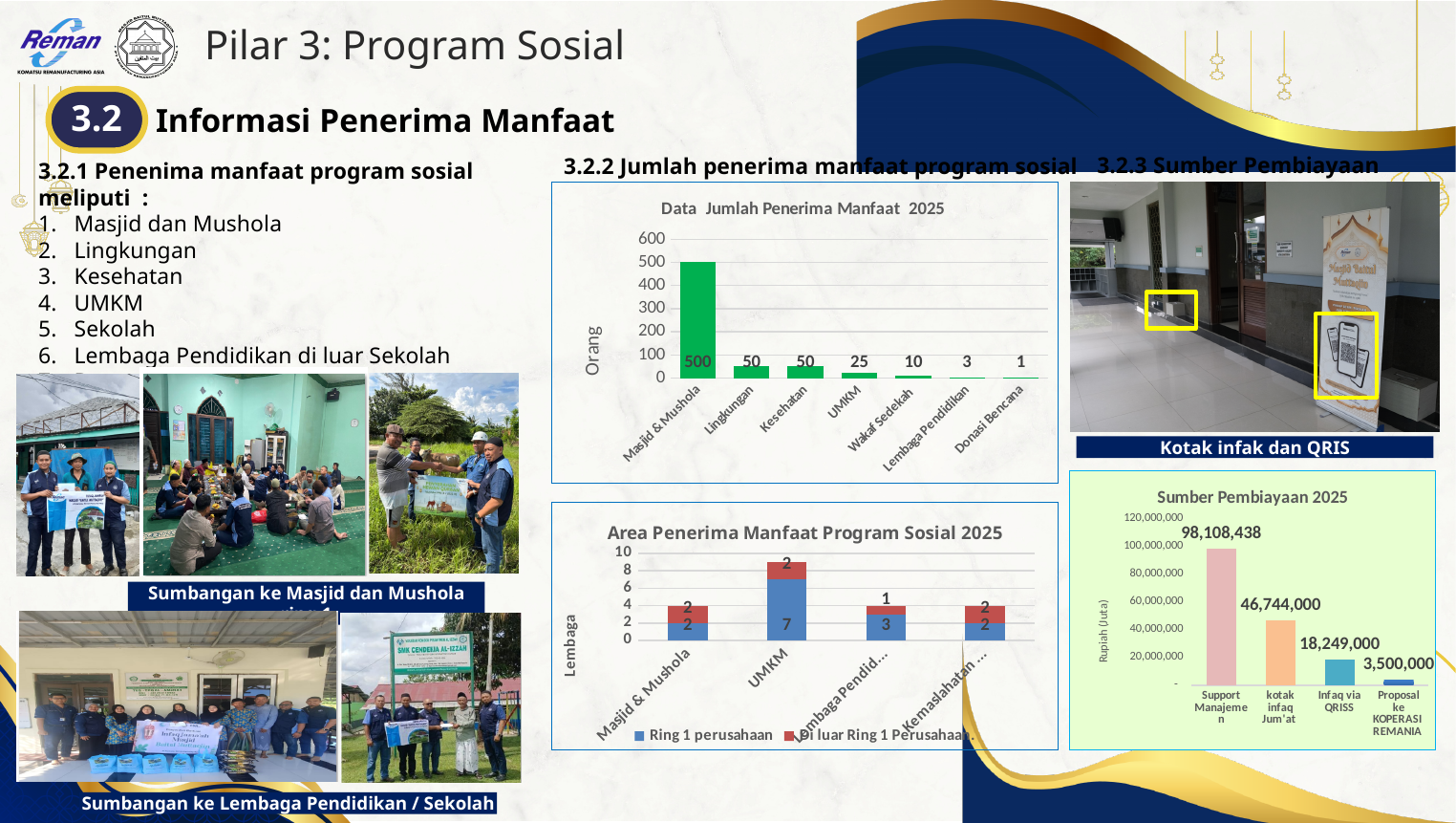
How many series does the legend of the 'Area Penerima Manfaat Program Sosial 2025' chart list? 2 In the 'Area Penerima Manfaat Program Sosial 2025' chart, what is the total of the stacked bar for UMKM? 9 In the 'Area Penerima Manfaat Program Sosial 2025' chart, what is the Ring 1 perusahaan value for UMKM? 7 In the 'Sumber Pembiayaan 2025' chart, which is larger: Infaq via QRISS or Proposal ke KOPERASI REMANIA? Infaq via QRISS What kind of chart is 'Area Penerima Manfaat Program Sosial 2025'? Stacked bar chart In the 'Sumber Pembiayaan 2025' chart, what is the value for kotak infaq Jum'at? 46,744,000 In the 'Data Jumlah Penerima Manfaat 2025' chart, what is the difference between the values for UMKM and Wakaf Sedekah? 15 In the 'Data Jumlah Penerima Manfaat 2025' chart, which category has the lowest value? Donasi Bencana In the 'Sumber Pembiayaan 2025' chart, which category has the highest value? Support Manajemen How many categories are shown in the 'Data Jumlah Penerima Manfaat 2025' chart? 7 In the 'Data Jumlah Penerima Manfaat 2025' chart, what is the value for Masjid & Mushola? 500 In the 'Data Jumlah Penerima Manfaat 2025' chart, what is the value for Lembaga Pendidikan? 3